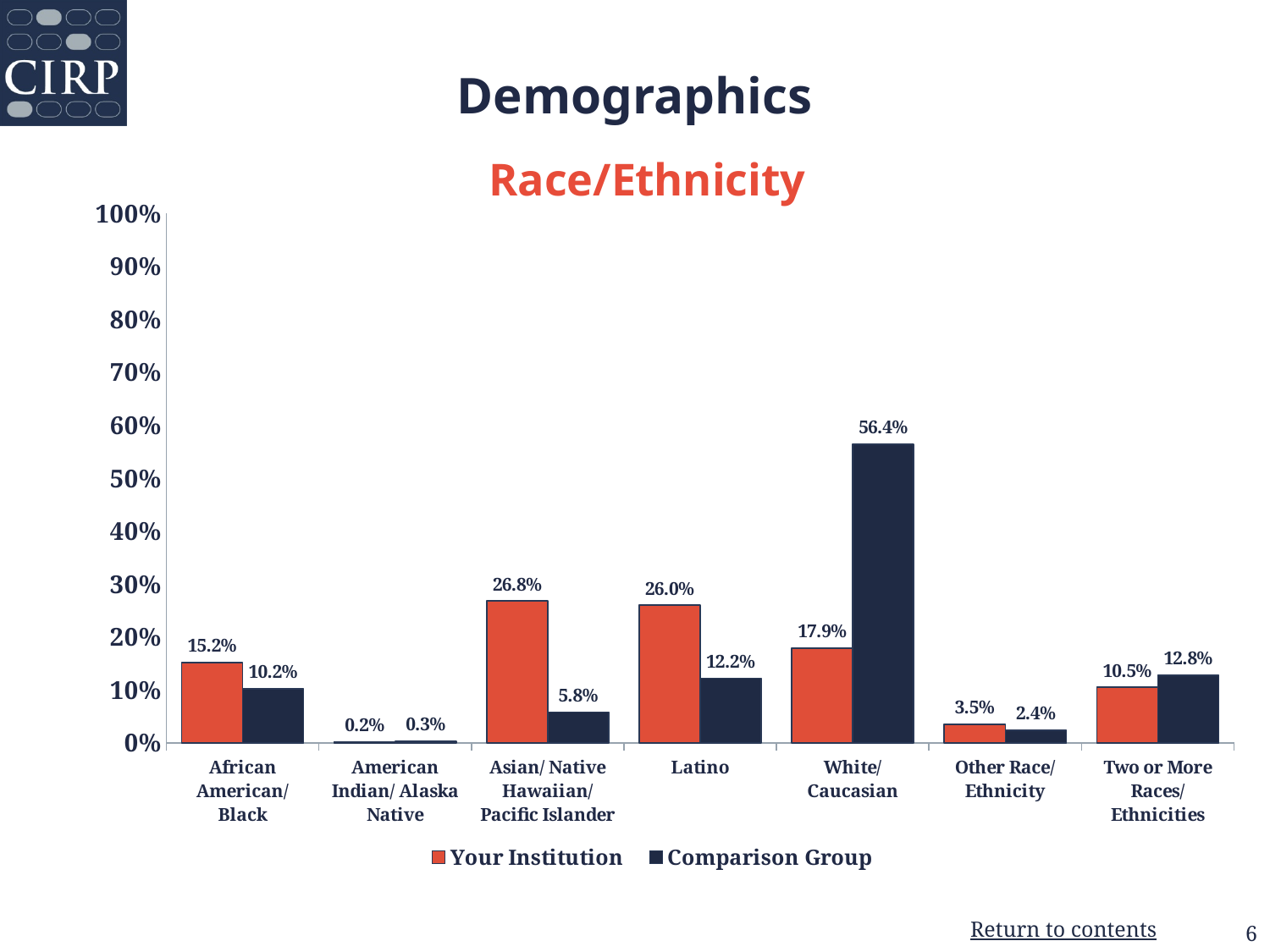
How many series does the legend list? 2 What is the Comparison Group value for White/Caucasian? 56.4% What is the Your Institution value for Other Race/Ethnicity? 3.5% Which category has the lowest Comparison Group value? American Indian/Alaska Native What is the Comparison Group value for Asian/Native Hawaiian/Pacific Islander? 5.8% Which is larger for African American/Black: Your Institution or Comparison Group? Your Institution How many race/ethnicity categories are shown on the x axis? 7 What is the Your Institution value for Latino? 26.0% Is the Comparison Group value for White/Caucasian greater or less than 50%? greater What kind of chart is shown on the slide? Bar chart What is the difference between the Comparison Group and Your Institution values for White/Caucasian? 38.5% Which category has the highest Your Institution value? Asian/Native Hawaiian/Pacific Islander